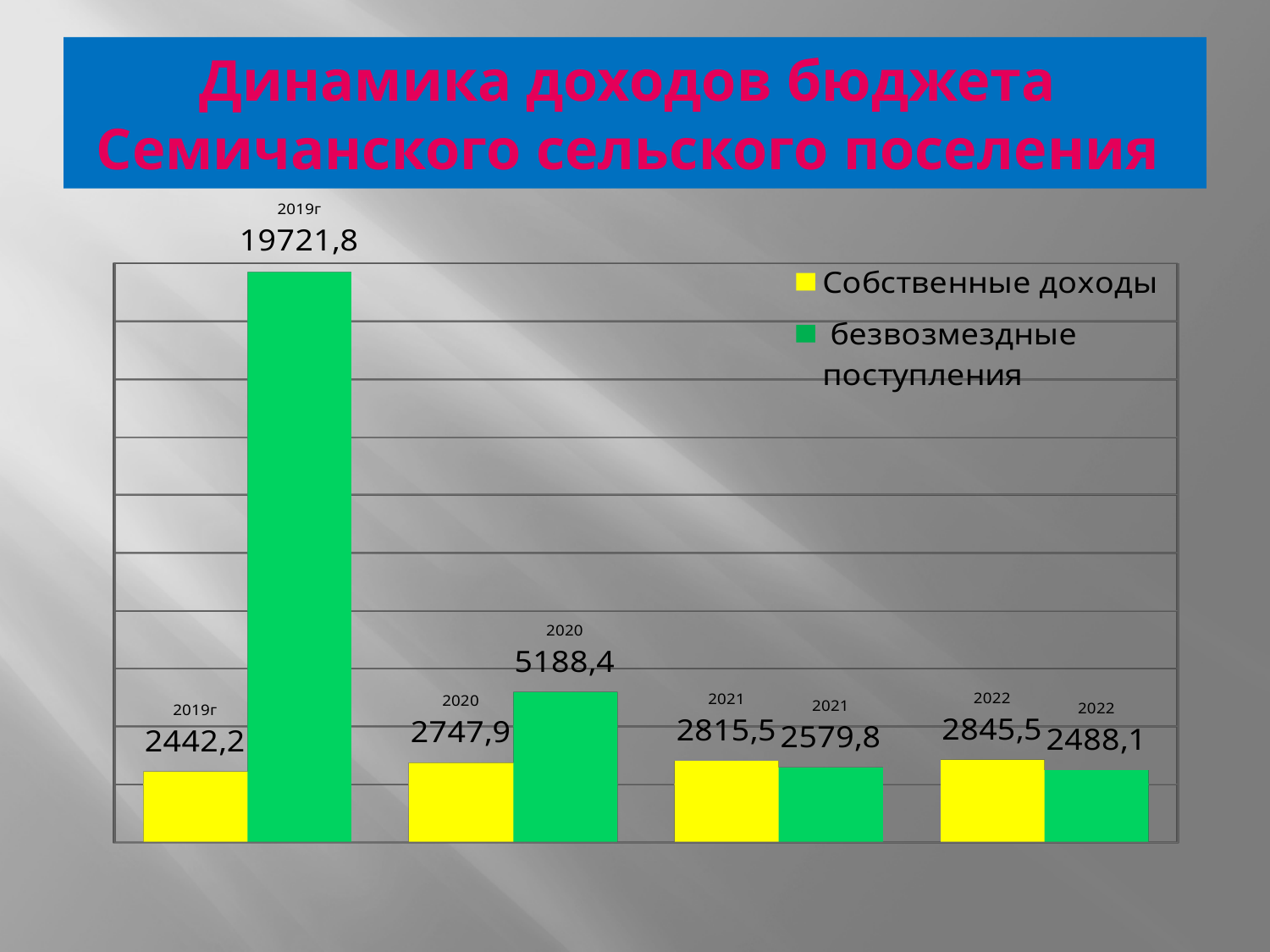
In which year is безвозмездные поступления highest? 2019г Which colour represents Собственные доходы in the chart? yellow What is the value of Собственные доходы for 2020? 2747,9 What is the difference between безвозмездные поступления and Собственные доходы in 2020? 2440,5 Do the values of Собственные доходы rise or fall from 2019г to 2022? rise How many years (categories) are shown on the x axis? 4 In which year is Собственные доходы lowest? 2019г What is the value of безвозмездные поступления for 2022? 2488,1 What is the value of безвозмездные поступления for 2019г? 19721,8 What kind of chart is shown on the slide? bar chart Which is larger in 2021: Собственные доходы or безвозмездные поступления? Собственные доходы How many series does the legend list? 2